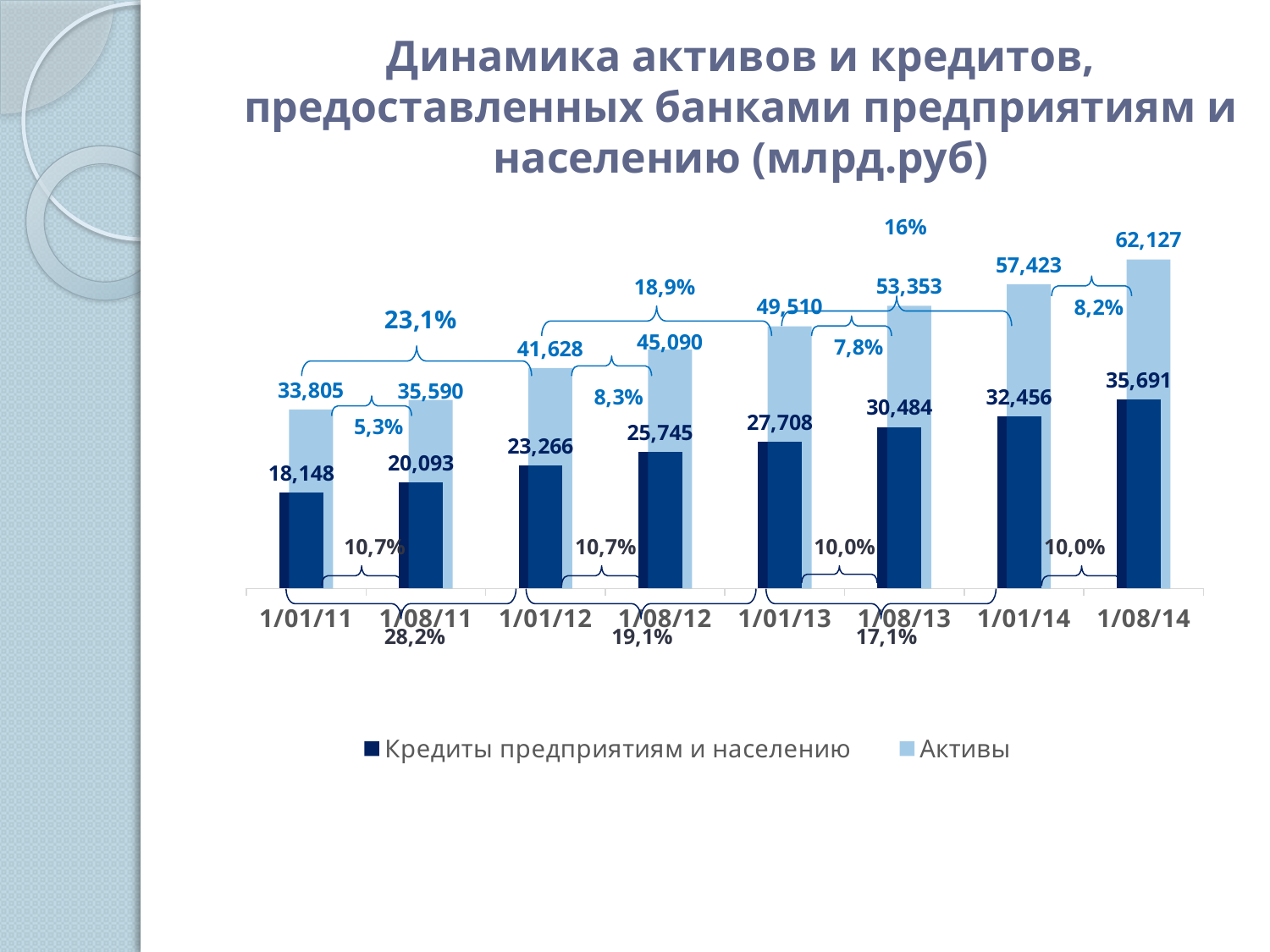
How many dates are shown on the x axis? 8 How many series does the legend list? 2 Which is larger: Кредиты предприятиям и населению on 1/01/14 or Активы on 1/01/11? Активы on 1/01/11 What is the value of Активы on 1/01/13? 49,510 What type of chart is shown on the slide? Bar chart What is the difference between Активы and Кредиты предприятиям и населению on 1/08/14? 26,436 What is the value of Кредиты предприятиям и населению on 1/08/12? 25,745 What is the value of Активы on 1/08/14? 62,127 What is the value of Кредиты предприятиям и населению on 1/01/11? 18,148 On which date is the value of Активы the highest? 1/08/14 Do the values of Активы rise or fall from 1/01/11 to 1/08/14? Rise On which date is the value of Кредиты предприятиям и населению the lowest? 1/01/11